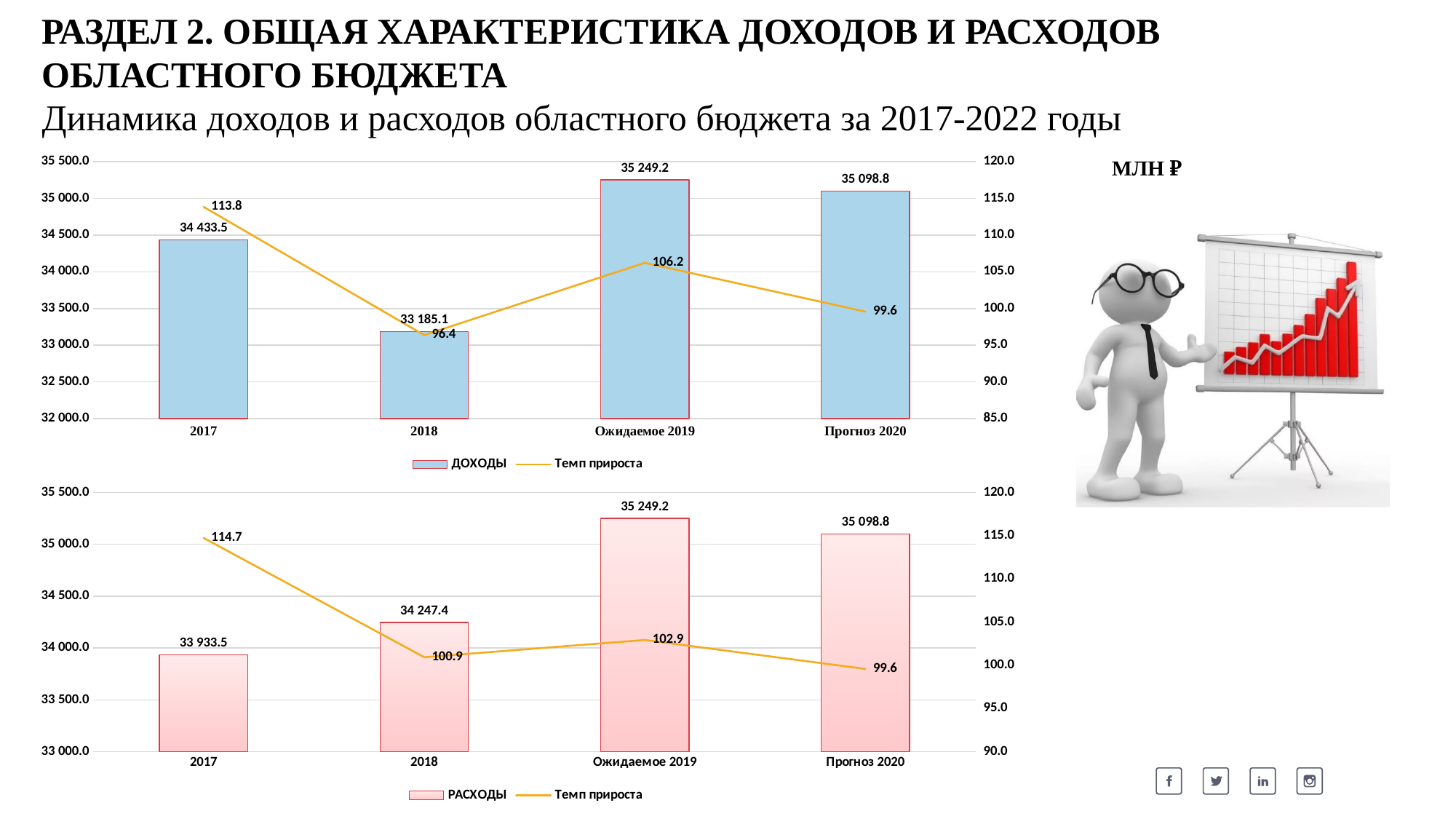
In the top chart (ДОХОДЫ), which category has the lowest Темп прироста value? 2018 In the top chart (ДОХОДЫ), what is the value of ДОХОДЫ for 2018? 33 185.1 In the top chart (ДОХОДЫ), what is the difference between the ДОХОДЫ values for Ожидаемое 2019 and Прогноз 2020? 150.4 In the bottom chart (РАСХОДЫ), what is the value of РАСХОДЫ for 2017? 33 933.5 In the bottom chart (РАСХОДЫ), which category has the lowest РАСХОДЫ value? 2017 In the top chart (ДОХОДЫ), what is the Темп прироста value for 2017? 113.8 How many series does the legend of the top chart (ДОХОДЫ) list? 2 In the bottom chart (РАСХОДЫ), is the РАСХОДЫ value for 2018 larger or smaller than the value for 2017? larger In the bottom chart (РАСХОДЫ), what is the Темп прироста value for Ожидаемое 2019? 102.9 In the bottom chart (РАСХОДЫ), does the Темп прироста line rise or fall from 2017 to 2018? fall In the top chart (ДОХОДЫ), which category has the highest ДОХОДЫ value? Ожидаемое 2019 In the bottom chart (РАСХОДЫ), how many categories are shown on the x axis? 4